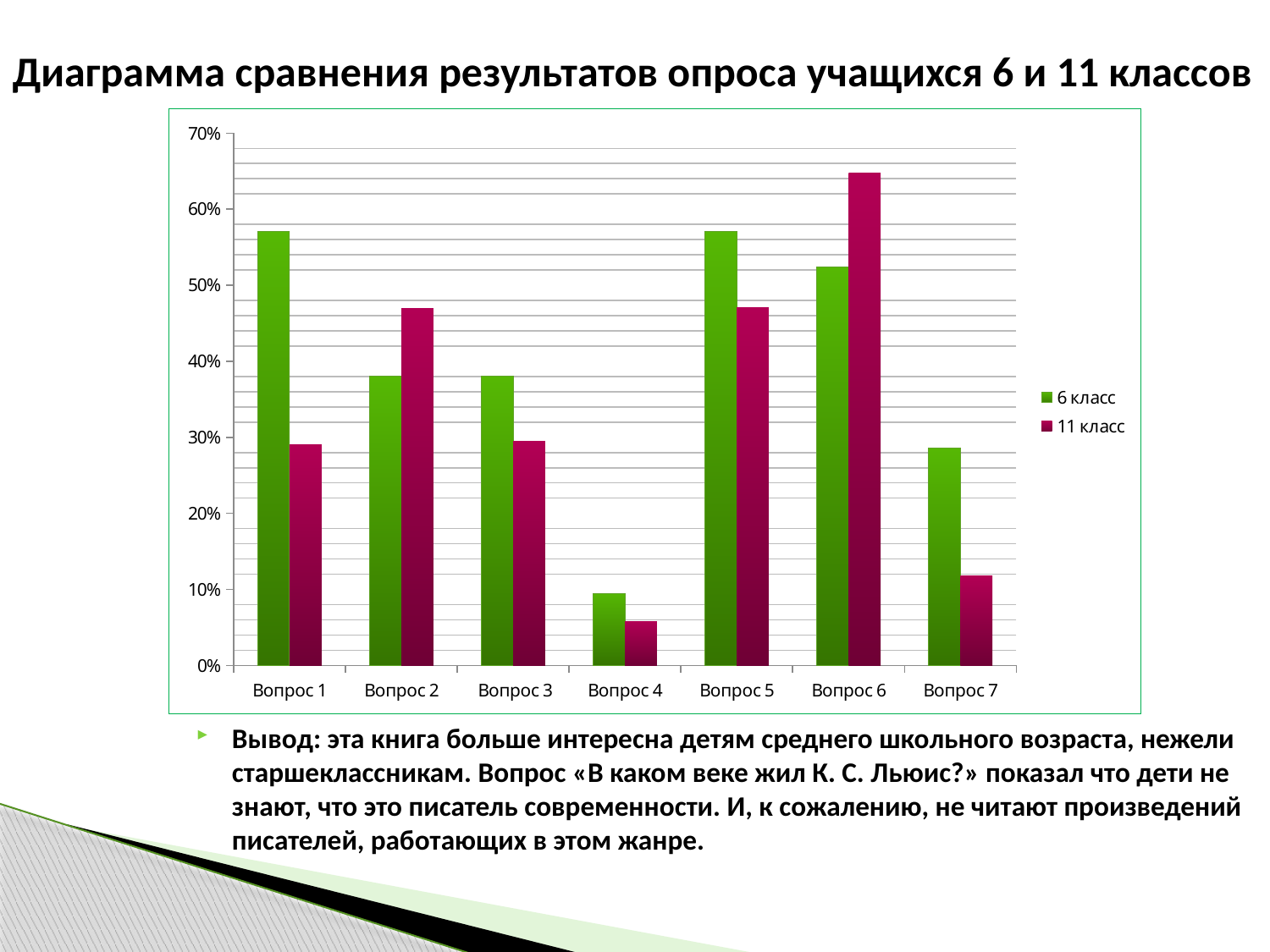
Which question has the highest value for the 11 класс series? Вопрос 6 Which question has the lowest value for the 6 класс series? Вопрос 4 How many series does the legend list? 2 Which question has the lowest value for the 11 класс series? Вопрос 4 For Вопрос 6, which series has the larger value, 6 класс or 11 класс? 11 класс How many categories (questions) are shown on the x axis? 7 For Вопрос 1, which series has the larger value, 6 класс or 11 класс? 6 класс What is the title of the chart on the slide? Диаграмма сравнения результатов опроса учащихся 6 и 11 классов Is the value for 6 класс at Вопрос 1 greater or less than 50%? greater Is the value for 11 класс at Вопрос 6 greater or less than 60%? greater What kind of chart is shown on the slide? bar chart